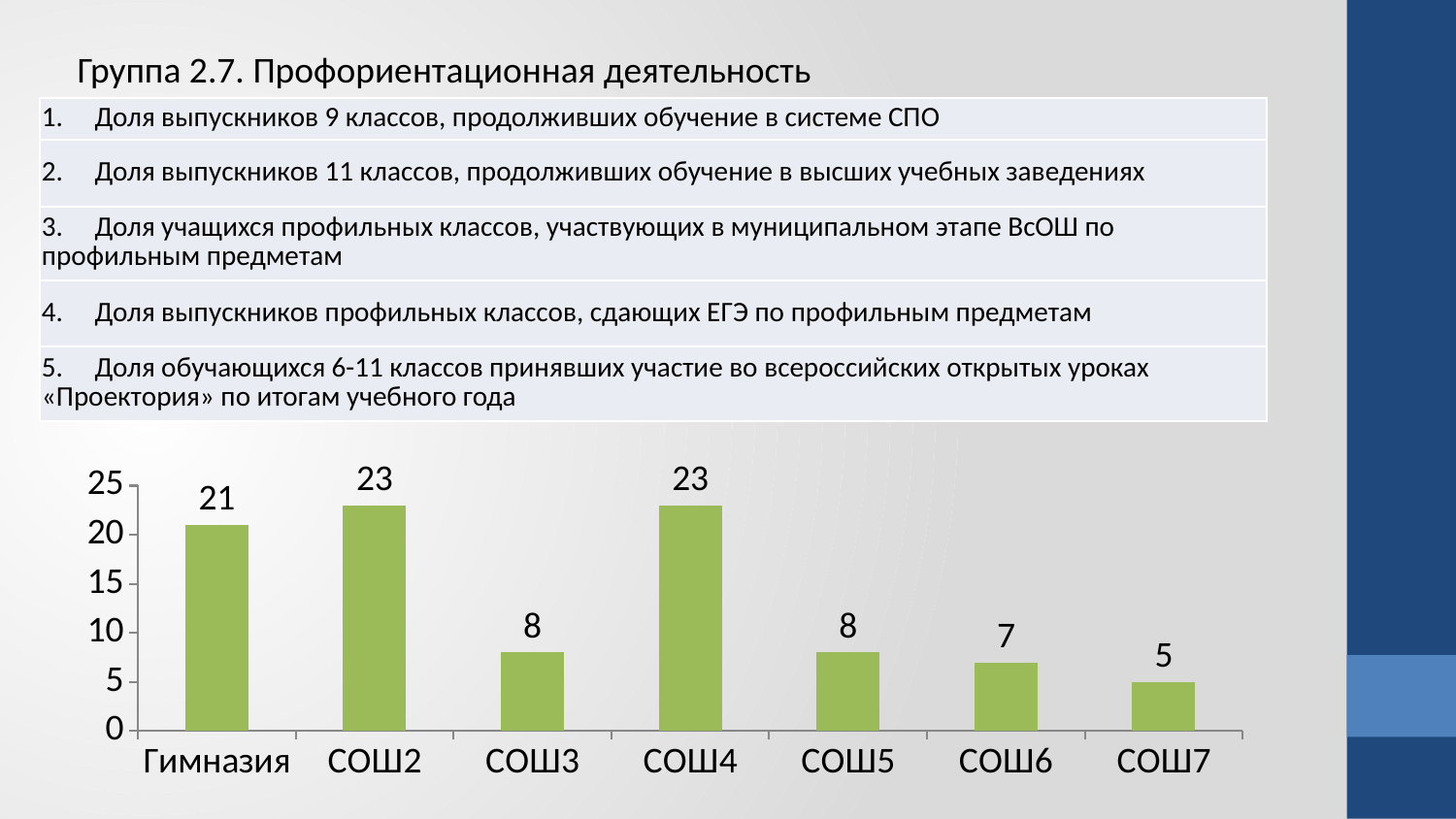
What kind of chart is shown on the slide? bar chart Is the value for СОШ6 greater or less than 10? less What is the value for СОШ3? 8 Which category has the lowest value? СОШ7 What is the difference between the values for СОШ2 and Гимназия? 2 What is the value for СОШ7? 5 What is the difference between the values for СОШ4 and СОШ7? 18 Which is larger, the value for Гимназия or the value for СОШ5? Гимназия What is the value for Гимназия? 21 What is the value for СОШ6? 7 What is the highest value shown in the chart? 23 How many categories are shown on the x axis? 7